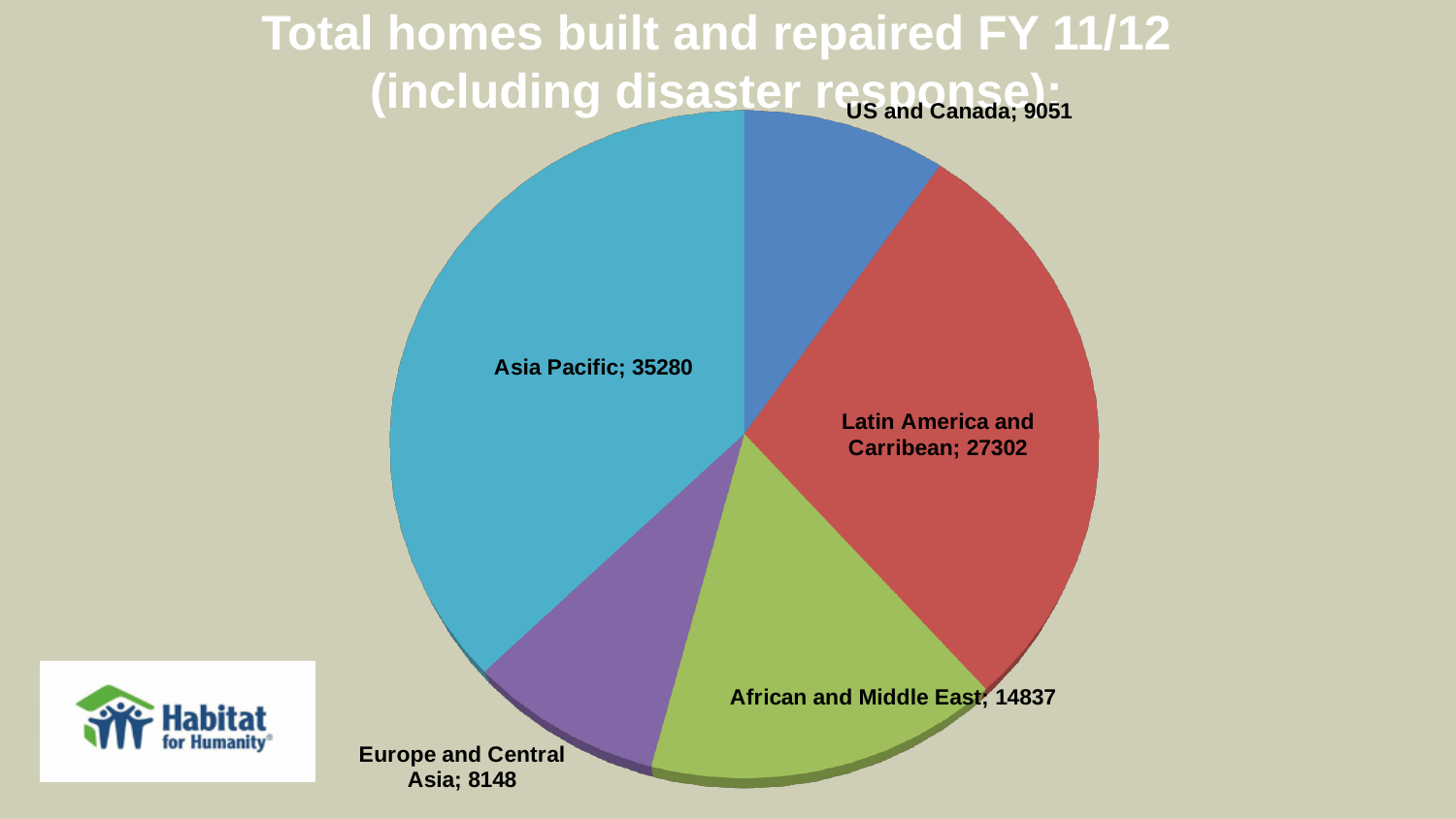
What is the difference between the values for Asia Pacific and Latin America and Carribean? 7978 What is the value for US and Canada? 9051 What is the value for Europe and Central Asia? 8148 What is the title of the chart? Total homes built and repaired FY 11/12 (including disaster response): Which is larger, the value for US and Canada or the value for Europe and Central Asia? US and Canada Which region has the largest slice of the pie? Asia Pacific Which region has the smallest slice of the pie? Europe and Central Asia What is the value for Latin America and Carribean? 27302 What is the total of all the slices in the pie chart? 94618 How many slices does the pie chart have? 5 What kind of chart is shown on the slide? Pie chart What is the value for Asia Pacific? 35280